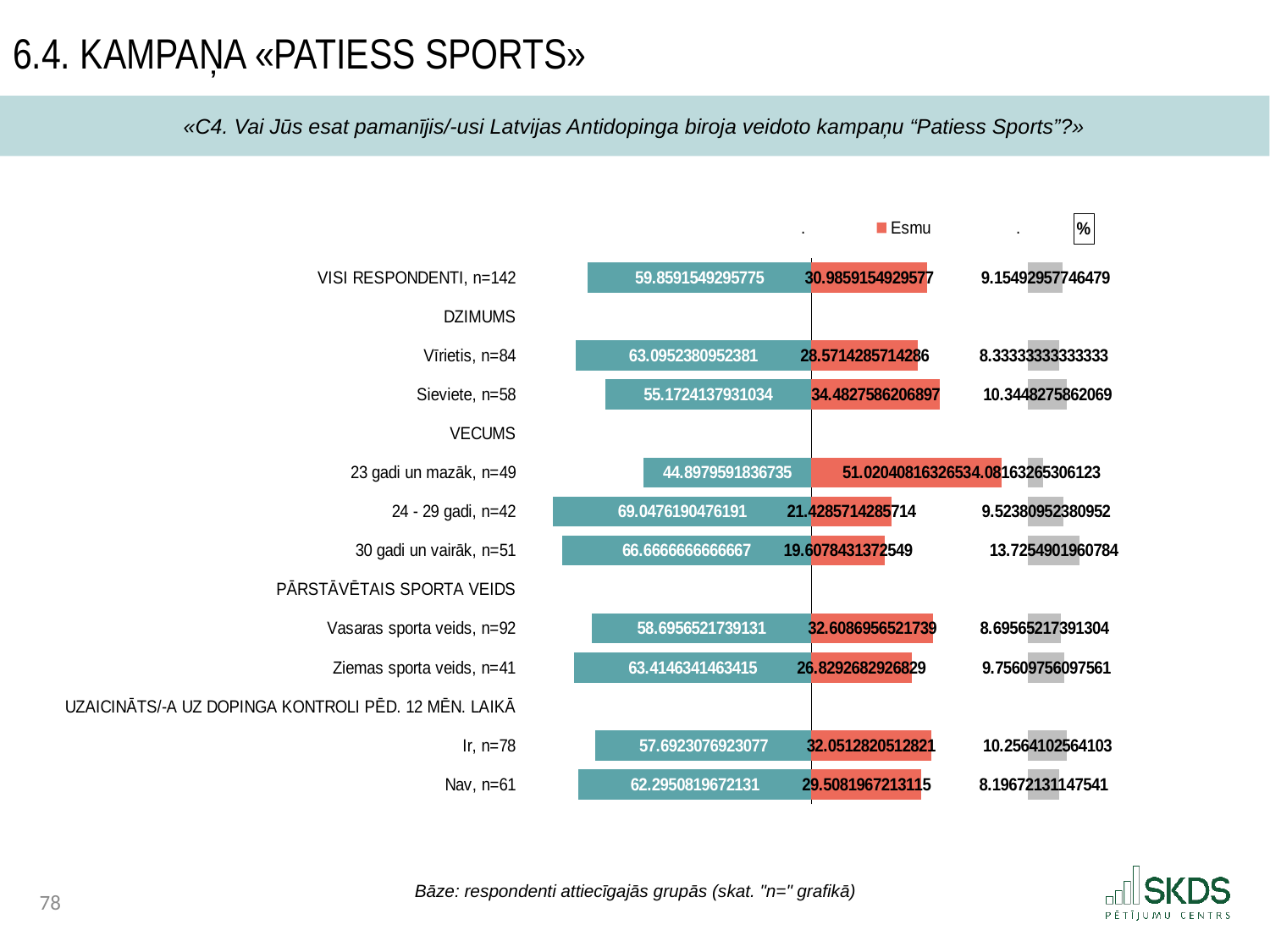
Which series name is readable in the chart legend? Esmu Which group has the highest "Esmu" value? 23 gadi un mazāk, n=49 Which has the larger "Esmu" value, Sieviete, n=58 or Vīrietis, n=84? Sieviete, n=58 What is the "Esmu" value for VISI RESPONDENTI, n=142? 30.9859154929577 What is the "Esmu" value for Vīrietis, n=84? 28.5714285714286 Which group has the lowest "Esmu" value? 30 gadi un vairāk, n=51 What kind of chart is shown on the slide? Bar chart Which has the larger "Esmu" value, Vasaras sporta veids, n=92 or Ziemas sporta veids, n=41? Vasaras sporta veids, n=92 What is the "Esmu" value for Nav, n=61? 29.5081967213115 What is the "Esmu" value for 30 gadi un vairāk, n=51? 19.6078431372549 Which has the larger "Esmu" value, 24 - 29 gadi, n=42 or 23 gadi un mazāk, n=49? 23 gadi un mazāk, n=49 How many respondent groups have bars plotted in the chart? 10